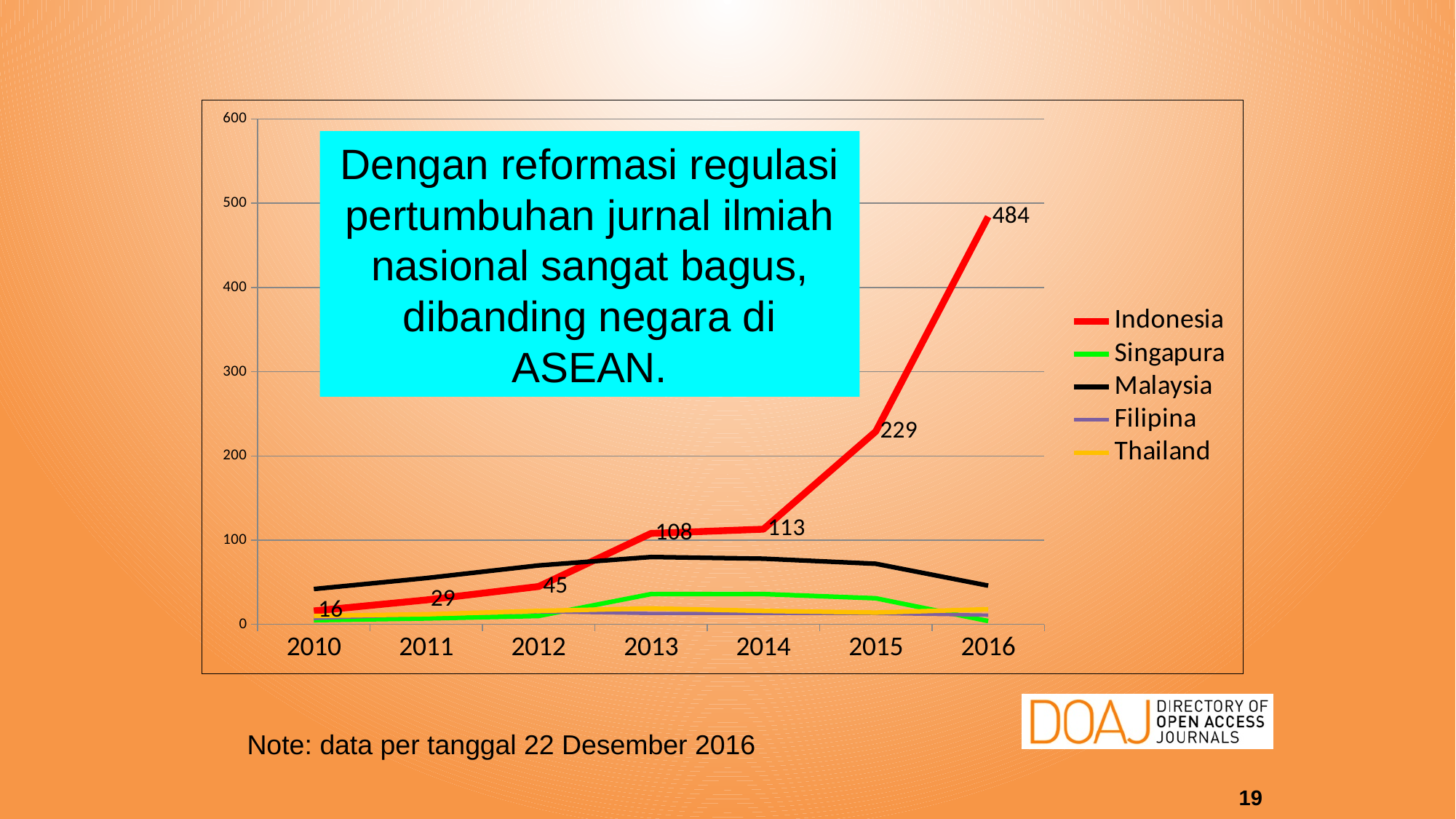
Which series is drawn in red? Indonesia Is the value for Malaysia in 2013 greater or less than 100? less What is the difference between the Indonesia values for 2016 and 2015? 255 How many series does the legend list? 5 In which year is the Indonesia value highest? 2016 What type of chart is shown on the slide? line chart How many years are shown on the x axis? 7 In which year is the Indonesia value lowest? 2010 What is the value for Indonesia in 2010? 16 What is the value for Indonesia in 2016? 484 Does the Indonesia line rise or fall from 2010 to 2016? rise What is the value for Indonesia in 2013? 108